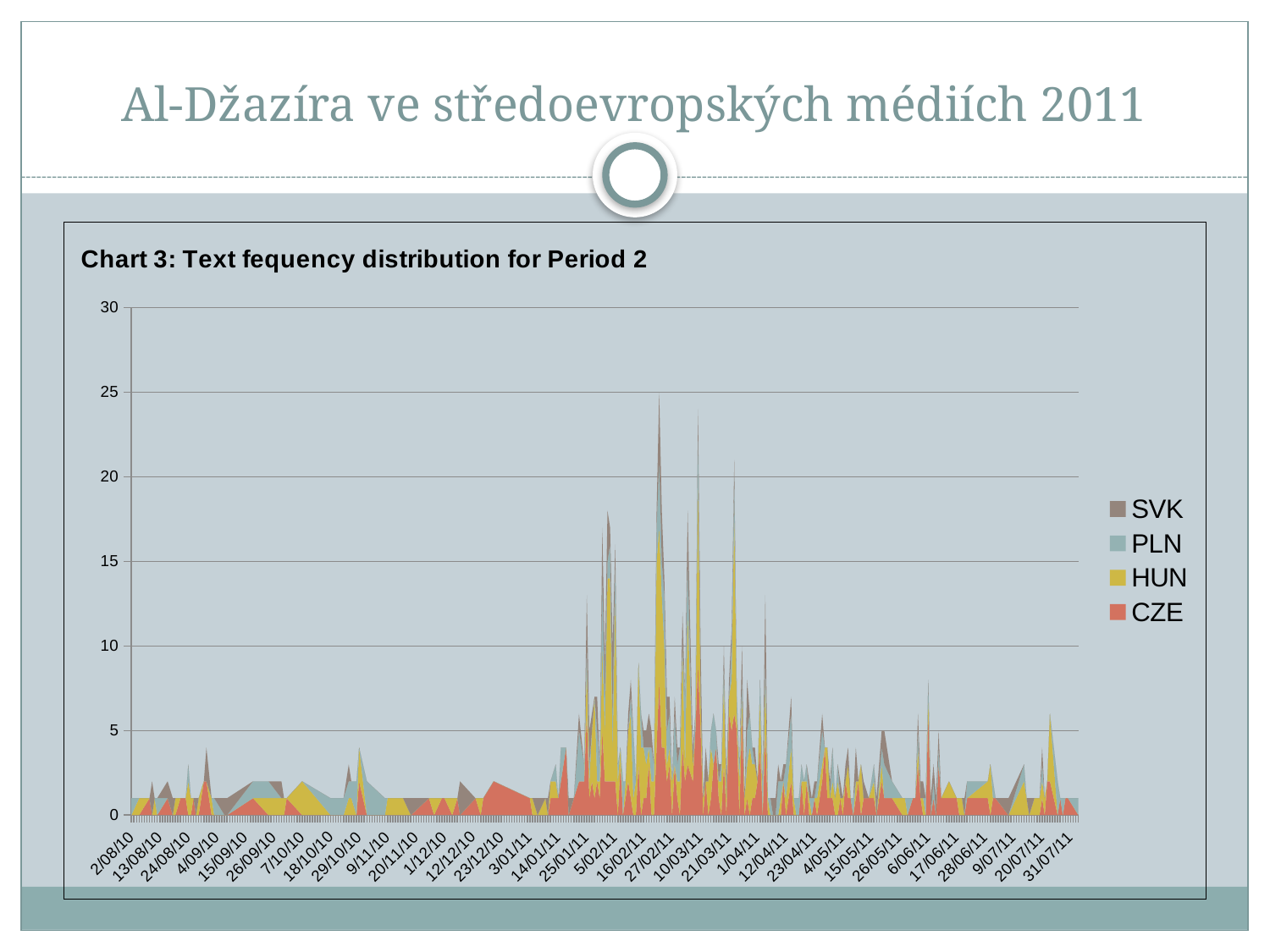
Is the stacked total at the peak near 5/02/11 greater or less than 15? greater Is the stacked total on 20/11/10 greater or less than 5? less What kind of chart is shown on the slide? Area chart What is the first date label on the x axis? 2/08/10 Is the stacked total on 2/08/10 greater or less than 5? less What are the series listed in the legend? SVK, PLN, HUN, CZE Do the values generally rise or fall from 3/01/11 to 27/02/11? rise How many series does the legend list? 4 What is the last date label on the x axis? 31/07/11 Do the values generally rise or fall from 21/03/11 to 31/07/11? fall What is the title of the chart? Chart 3: Text fequency distribution for Period 2